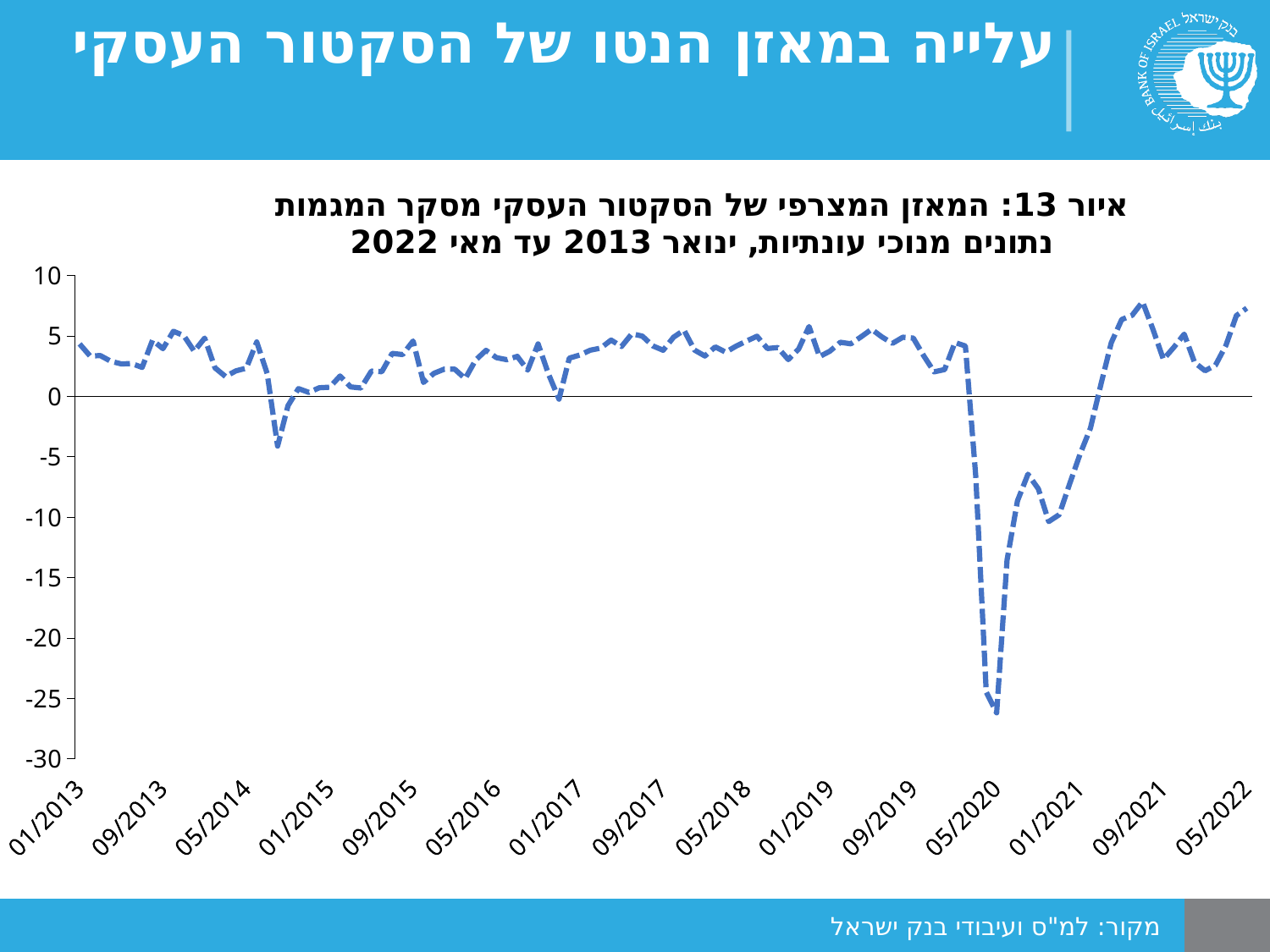
In which year does the series reach its lowest value? 2020 What kind of chart is shown on the slide? Line chart What is the highest value shown on the y axis? 10 Is the value at 01/2021 greater or less than 0? less Is the value at 05/2022 greater or less than 5? greater Which is larger, the value at 01/2013 or the value at 01/2021? 01/2013 Does the series rise or fall between 01/2021 and 09/2021? rise How many series are plotted in the chart? 1 What is the figure number given in the chart title? 13 Is the lowest value of the series greater or less than -20? less How many date labels are shown on the x axis? 15